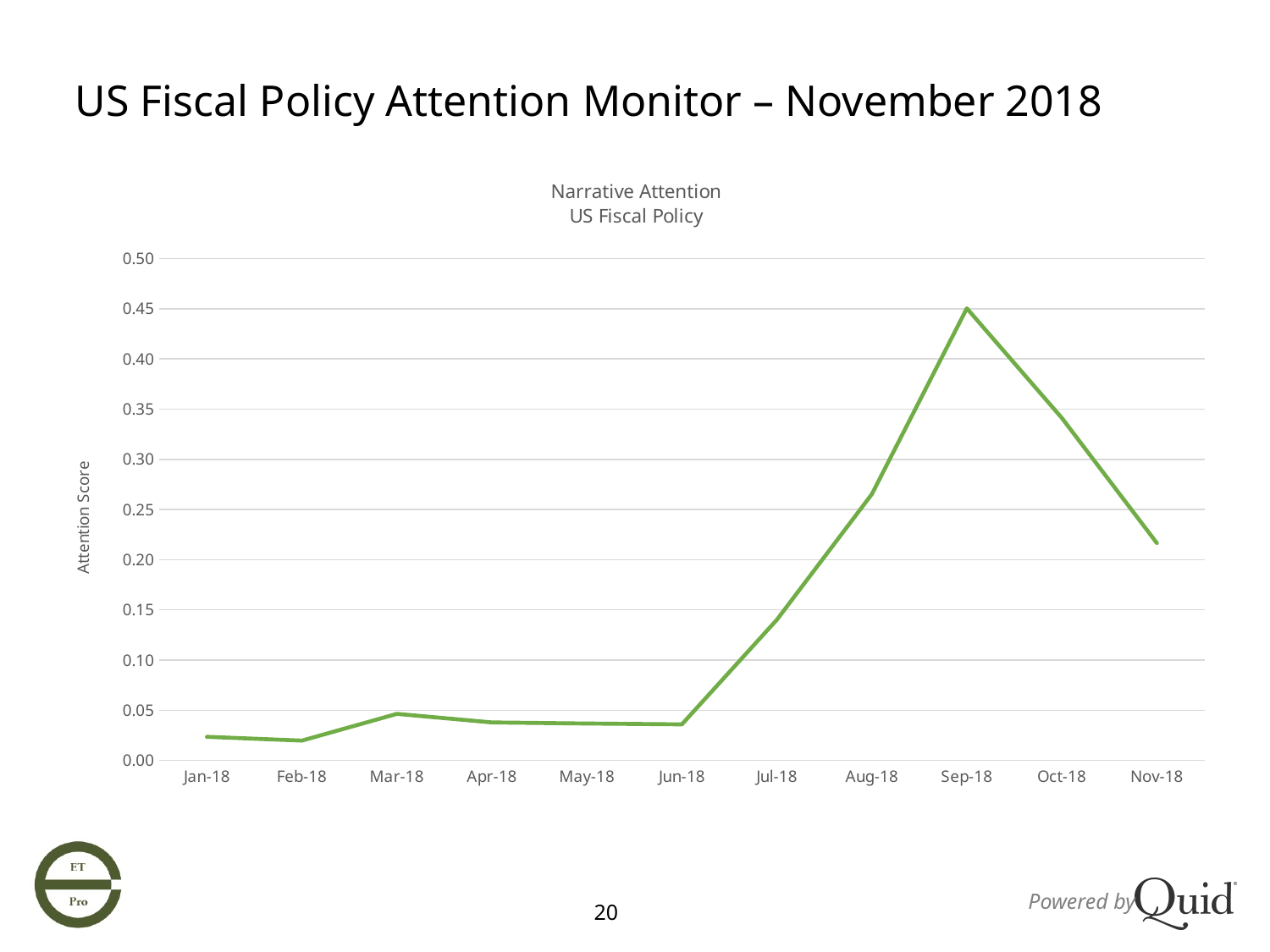
Is the value for Nov-18 greater or less than 0.20? greater Is the value for Aug-18 greater or less than 0.25? greater Does the attention score rise or fall from Jun-18 to Sep-18? rise Is the value for Jul-18 greater or less than 0.15? less How many months are plotted on the x axis? 11 What is the attention score for Sep-18? 0.45 Does the attention score rise or fall from Sep-18 to Nov-18? fall Which is larger, the value for Oct-18 or the value for Nov-18? Oct-18 Which month has the highest attention score? Sep-18 What kind of chart is shown on the slide? line chart What is the label on the y axis of the chart? Attention Score